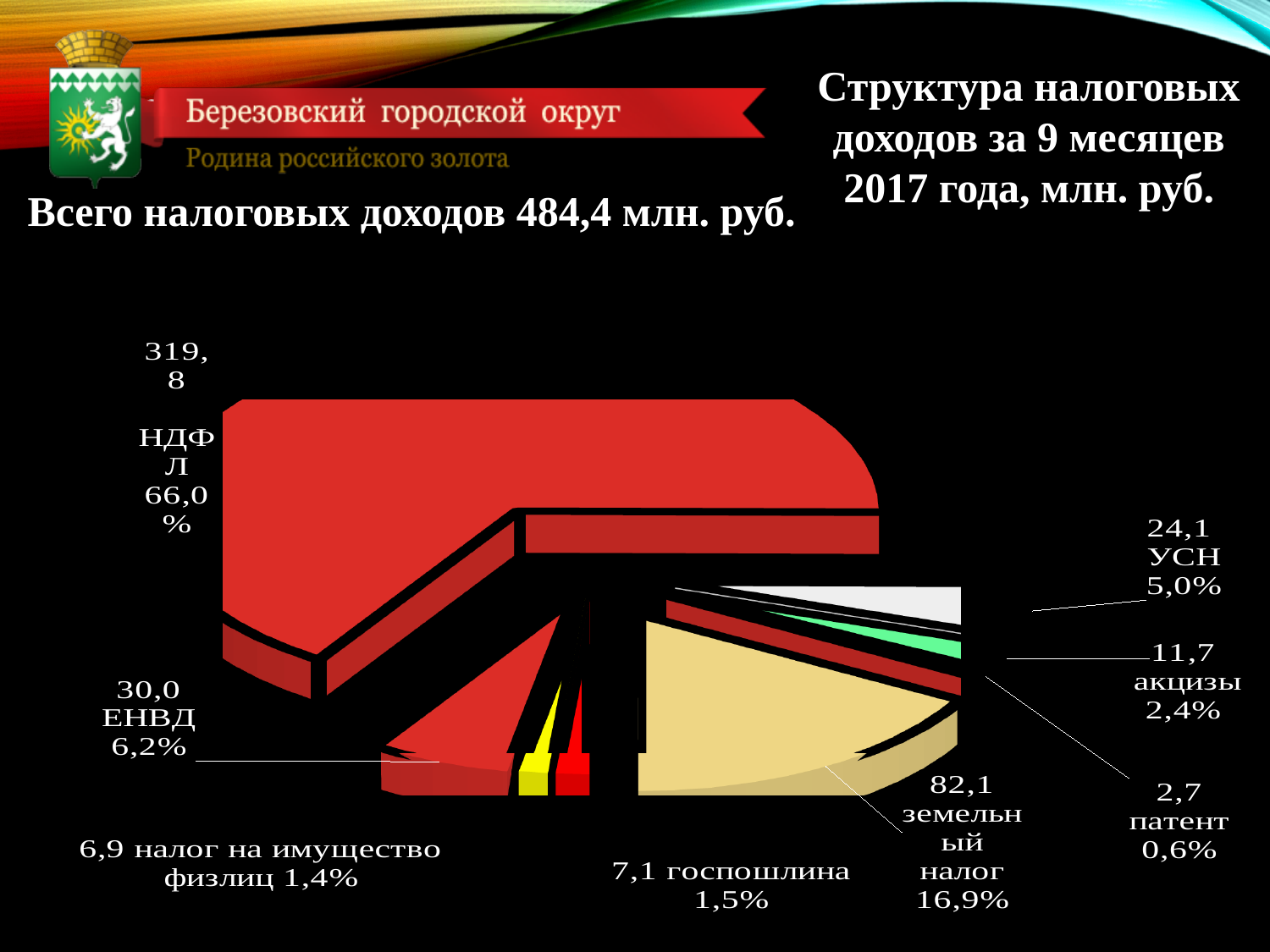
What is the difference between the values for ЕНВД and УСН? 5,9 Which is larger, the value for акцизы or the value for госпошлина? акцизы What type of chart is shown on the slide? pie chart What share of the pie does патент account for? 0,6% What share of the pie does земельный налог account for? 16,9% What is the value for УСН? 24,1 How many slices does the pie chart have? 8 Which category has the largest slice of the pie? НДФЛ What is the value for НДФЛ in the pie chart? 319,8 Which category has the smallest slice of the pie? патент What is the value for земельный налог? 82,1 What share of the pie does НДФЛ account for? 66,0%